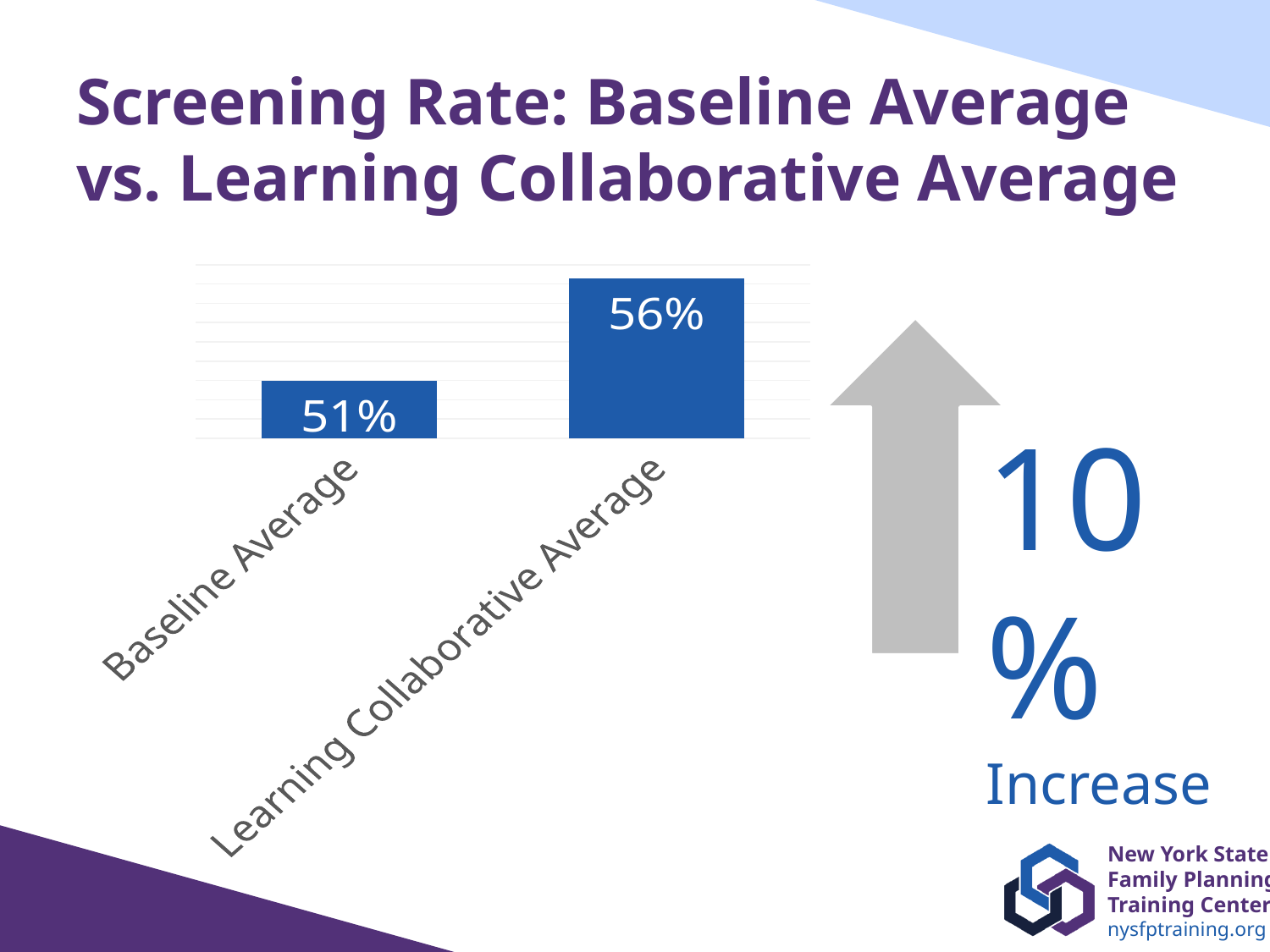
What percentage increase is stated next to the arrow beside the chart? 10% What is the value for Learning Collaborative Average? 56% Do the values rise or fall from Baseline Average to Learning Collaborative Average? Rise How many categories are shown in the chart? 2 What kind of chart is shown on the slide? Bar chart What is the difference between the Learning Collaborative Average and the Baseline Average? 5% Which is larger, the Baseline Average or the Learning Collaborative Average? Learning Collaborative Average What is the value for Baseline Average? 51% What is the title of the slide containing the chart? Screening Rate: Baseline Average vs. Learning Collaborative Average Which category has the highest value? Learning Collaborative Average Which category has the lowest value? Baseline Average